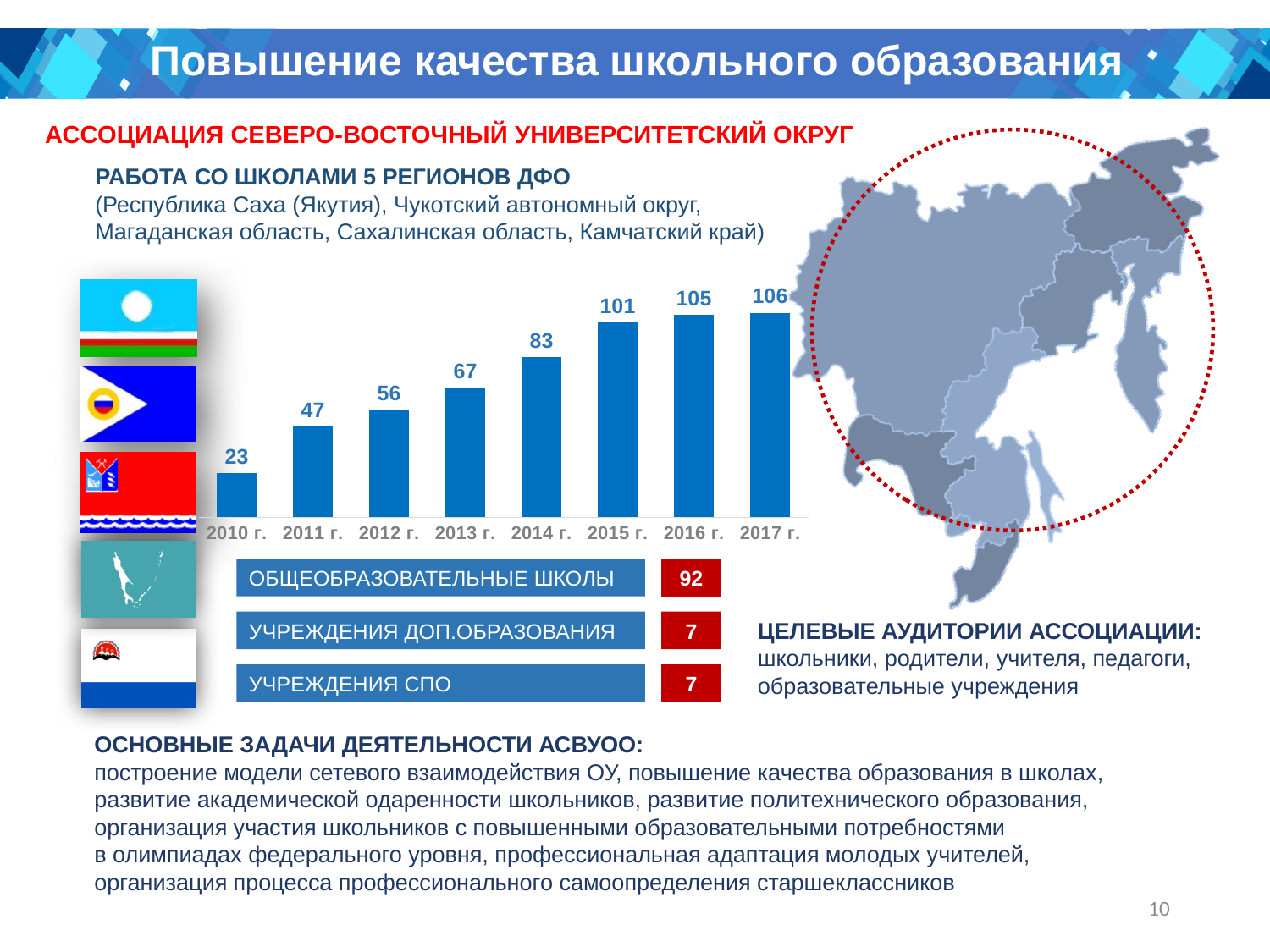
What is the difference between the values for 2011 г. and 2010 г. in the bar chart? 24 What is the value for 2017 г. in the bar chart? 106 Which year has the lowest value in the bar chart? 2010 г. How many years are shown on the x axis of the bar chart? 8 What is the value for 2010 г. in the bar chart? 23 What kind of chart is shown on the slide? bar chart What is the difference between the values for 2015 г. and 2012 г. in the bar chart? 45 What is the value for 2014 г. in the bar chart? 83 Which is larger in the bar chart, the value for 2013 г. or the value for 2012 г.? 2013 г. Which year has the highest value in the bar chart? 2017 г. Do the values in the bar chart rise or fall from 2010 г. to 2017 г.? rise What colour are the bars in the bar chart? blue